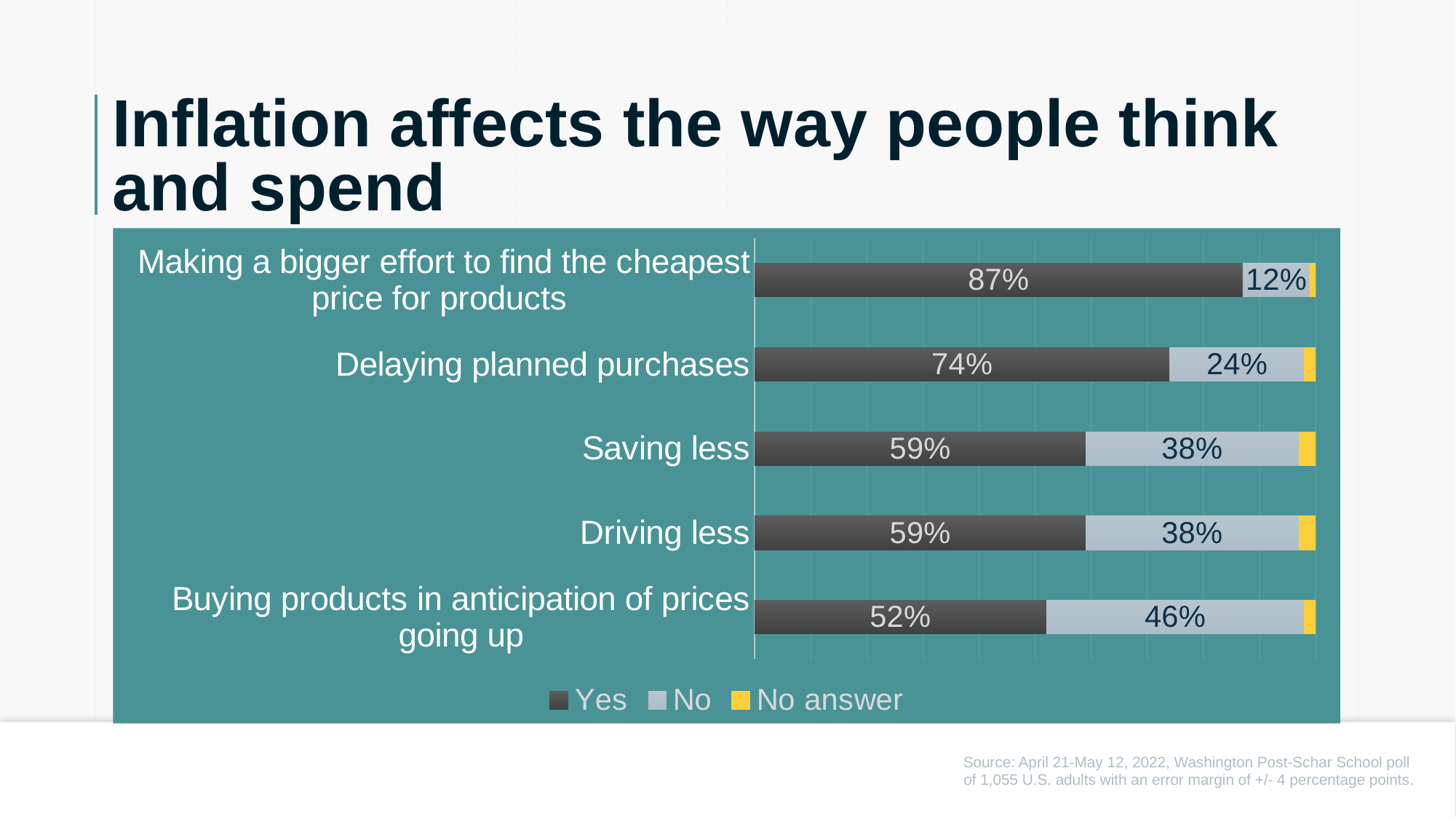
Which series is shown in yellow in the legend? No answer What kind of chart is shown on the slide? Stacked bar chart Which is larger: the No percentage for driving less or the No percentage for delaying planned purchases? Driving less What percentage of respondents said No to delaying planned purchases? 24% What is the Yes value for buying products in anticipation of prices going up? 52% What percentage of respondents said Yes to making a bigger effort to find the cheapest price for products? 87% What is the No value for saving less? 38% Which category has the highest Yes percentage? Making a bigger effort to find the cheapest price for products Which category has the lowest Yes percentage? Buying products in anticipation of prices going up How many categories are shown in the chart? 5 What is the difference between the Yes percentages for delaying planned purchases and saving less? 15% How many series does the legend list? 3